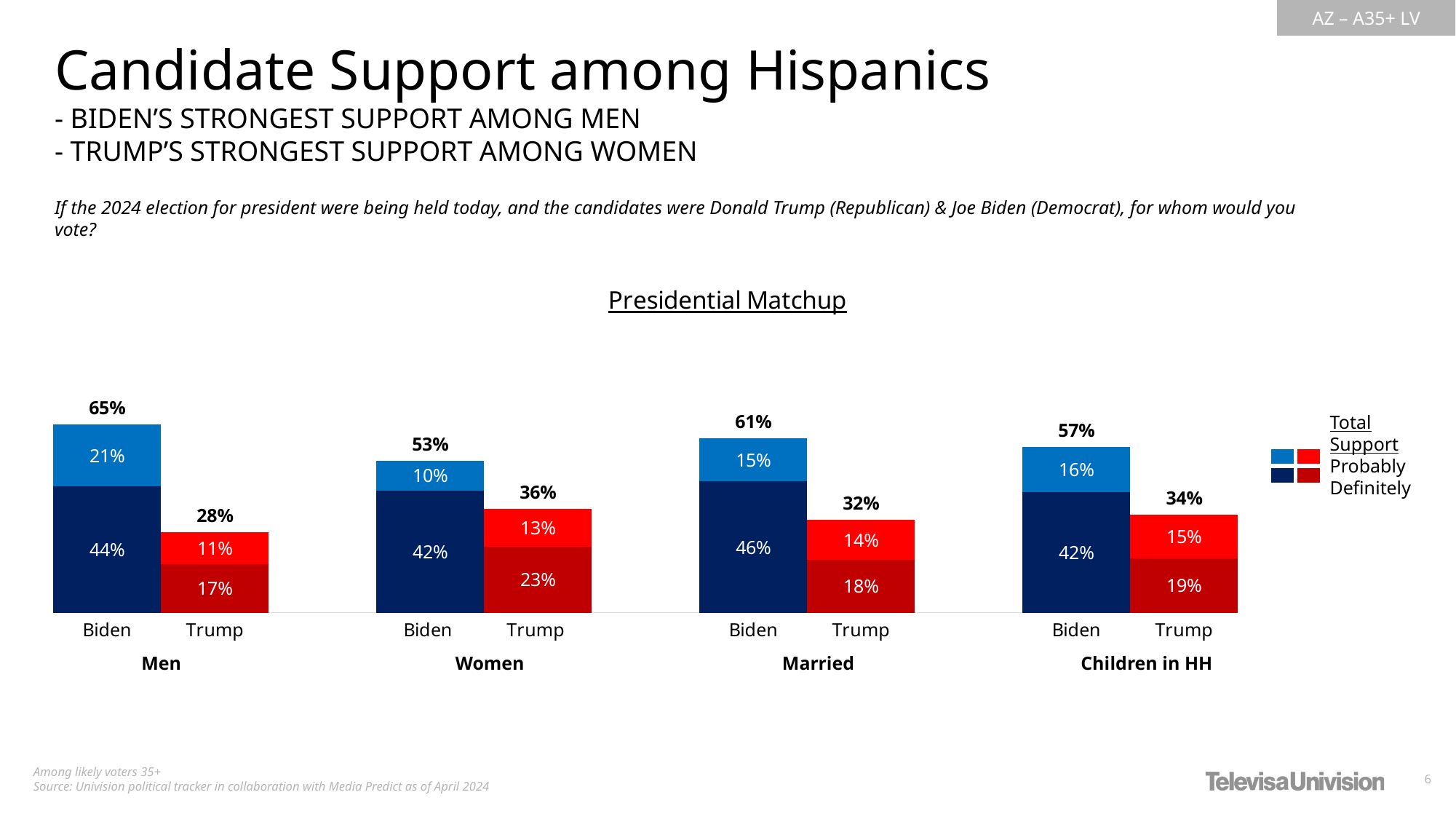
Among Married voters, who has higher total support, Biden or Trump? Biden What is the total support for Trump among voters with Children in HH? 34% What kind of chart is shown on the slide? Stacked bar chart How many demographic groups are shown in the chart? 4 In which group is Biden's total support highest? Men What is the total support for Biden among Men? 65% What is the 'Probably' support for Biden among Married voters? 15% What are the two support levels listed in the legend? Probably and Definitely What is the title of the chart? Presidential Matchup What is the difference between Biden's and Trump's total support among Women? 17% What is the 'Definitely' support for Trump among Women? 23% In which group is Trump's total support lowest? Men